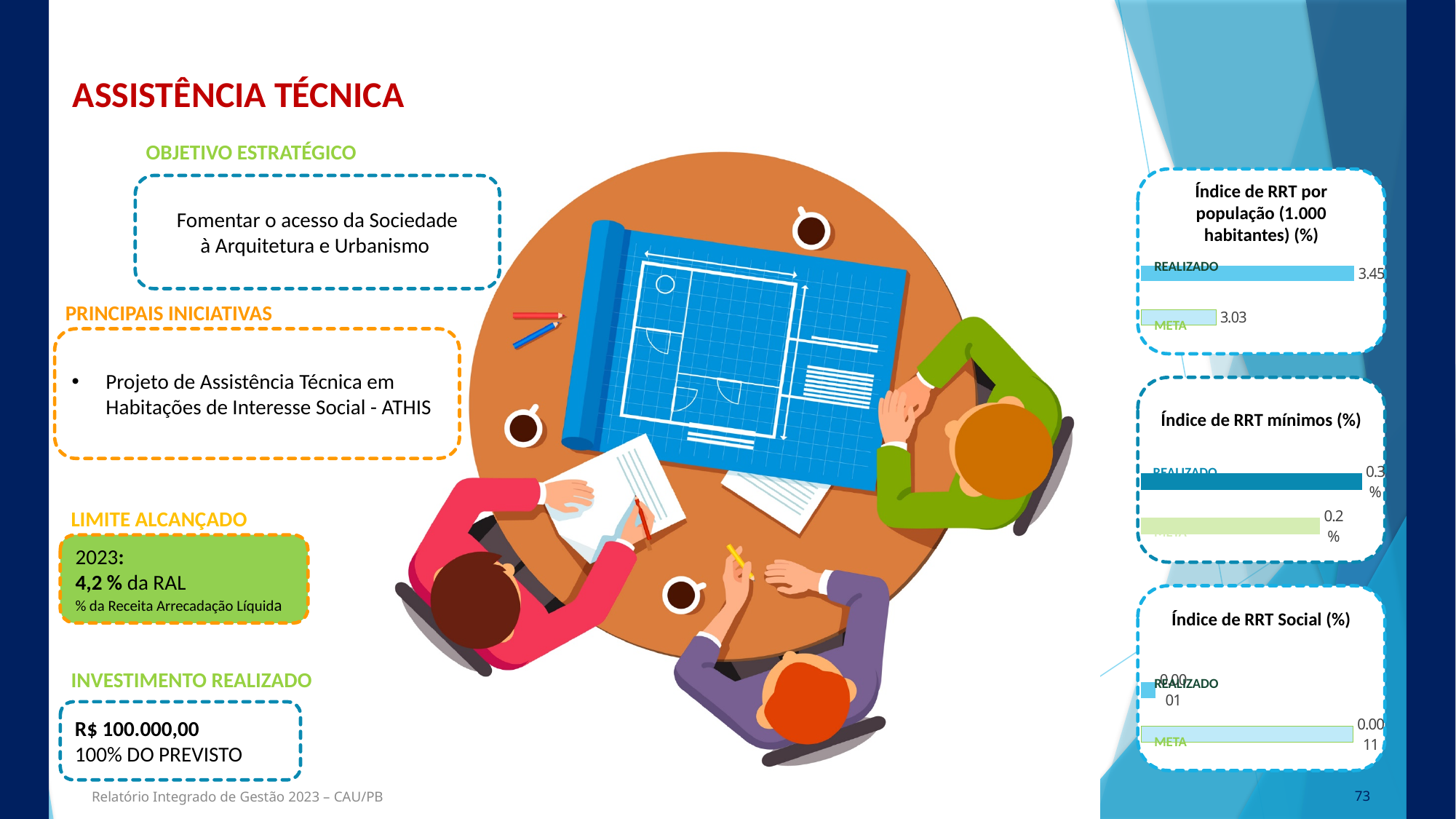
In the chart titled "Índice de RRT por população (1.000 habitantes) (%)", what is the difference between REALIZADO and META? 0.42 What kind of chart is the one titled "Índice de RRT mínimos (%)"? Bar chart In the chart titled "Índice de RRT por população (1.000 habitantes) (%)", which bar is larger, REALIZADO or META? REALIZADO In the chart titled "Índice de RRT mínimos (%)", which category has the highest value? REALIZADO In the chart titled "Índice de RRT Social (%)", which category has the lowest value? REALIZADO In the chart titled "Índice de RRT Social (%)", which bar is larger, REALIZADO or META? META How many charts are shown on the right side of the slide? 3 In the chart titled "Índice de RRT por população (1.000 habitantes) (%)", what is the value for META? 3.03 In the chart titled "Índice de RRT por população (1.000 habitantes) (%)", what is the value for REALIZADO? 3.45 How many bars are shown in the chart titled "Índice de RRT por população (1.000 habitantes) (%)"? 2 In the chart titled "Índice de RRT mínimos (%)", what is the value for REALIZADO? 0.3% In the chart titled "Índice de RRT mínimos (%)", what is the value for META? 0.2%